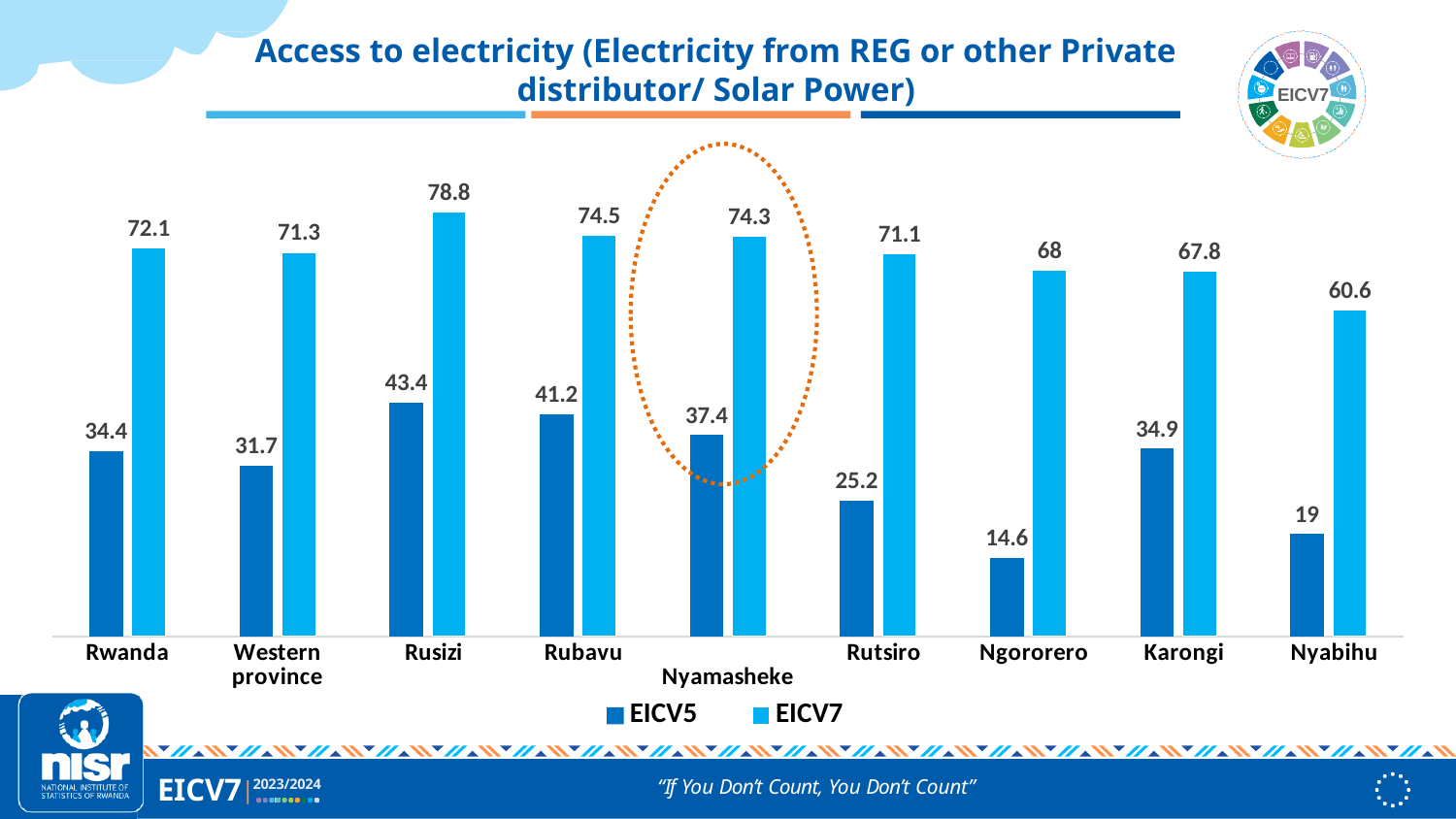
How many categories are shown on the x axis? 9 What is the EICV7 value for Rusizi? 78.8 What kind of chart is shown on the slide? Bar chart How many series does the legend list? 2 Which category has the lowest EICV7 value? Nyabihu What is the EICV7 value for Nyamasheke? 74.3 Which is larger, the EICV5 value for Rusizi or the EICV5 value for Rubavu? Rusizi What is the EICV5 value for Ngororero? 14.6 Which category has the lowest EICV5 value? Ngororero Which category has the highest EICV7 value? Rusizi Which series is shown in the darker blue colour? EICV5 What is the difference between the EICV7 and EICV5 values for Rwanda? 37.7